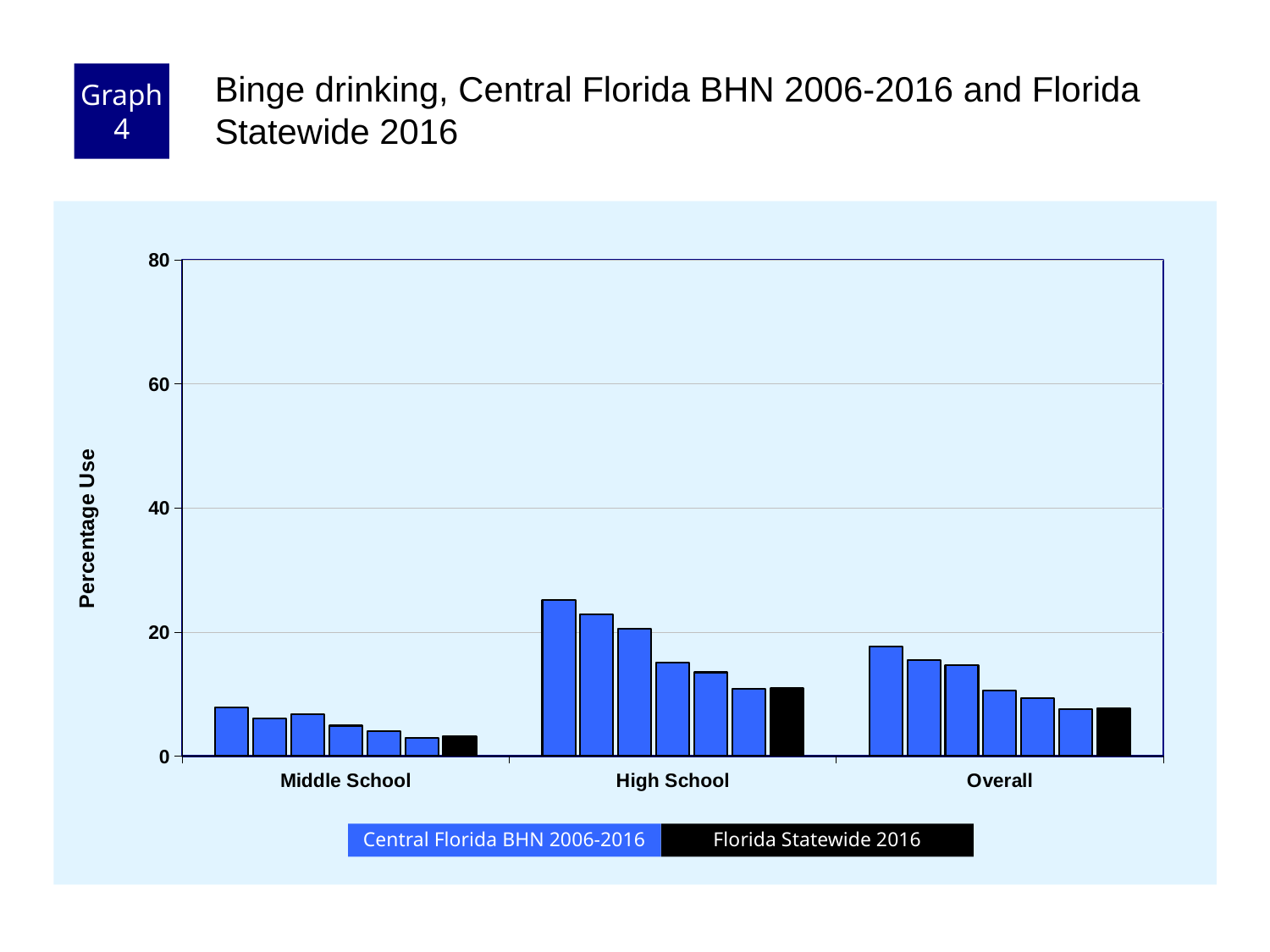
Is the Florida Statewide 2016 value for High School greater or less than 20? less How many school-level categories are shown on the x axis? 3 Is the tallest Central Florida BHN bar for High School greater or less than 20? greater How many series does the legend list? 2 Is the tallest Central Florida BHN bar for Overall greater or less than 20? less What is the label on the y axis? Percentage Use What kind of chart is shown on the slide? bar chart Within the High School group, do the Central Florida BHN bars rise or fall from 2006 to 2016? fall Which is larger, the Florida Statewide 2016 value for High School or for Middle School? High School Which category has the lowest binge drinking percentages? Middle School Which category has the highest binge drinking percentages? High School